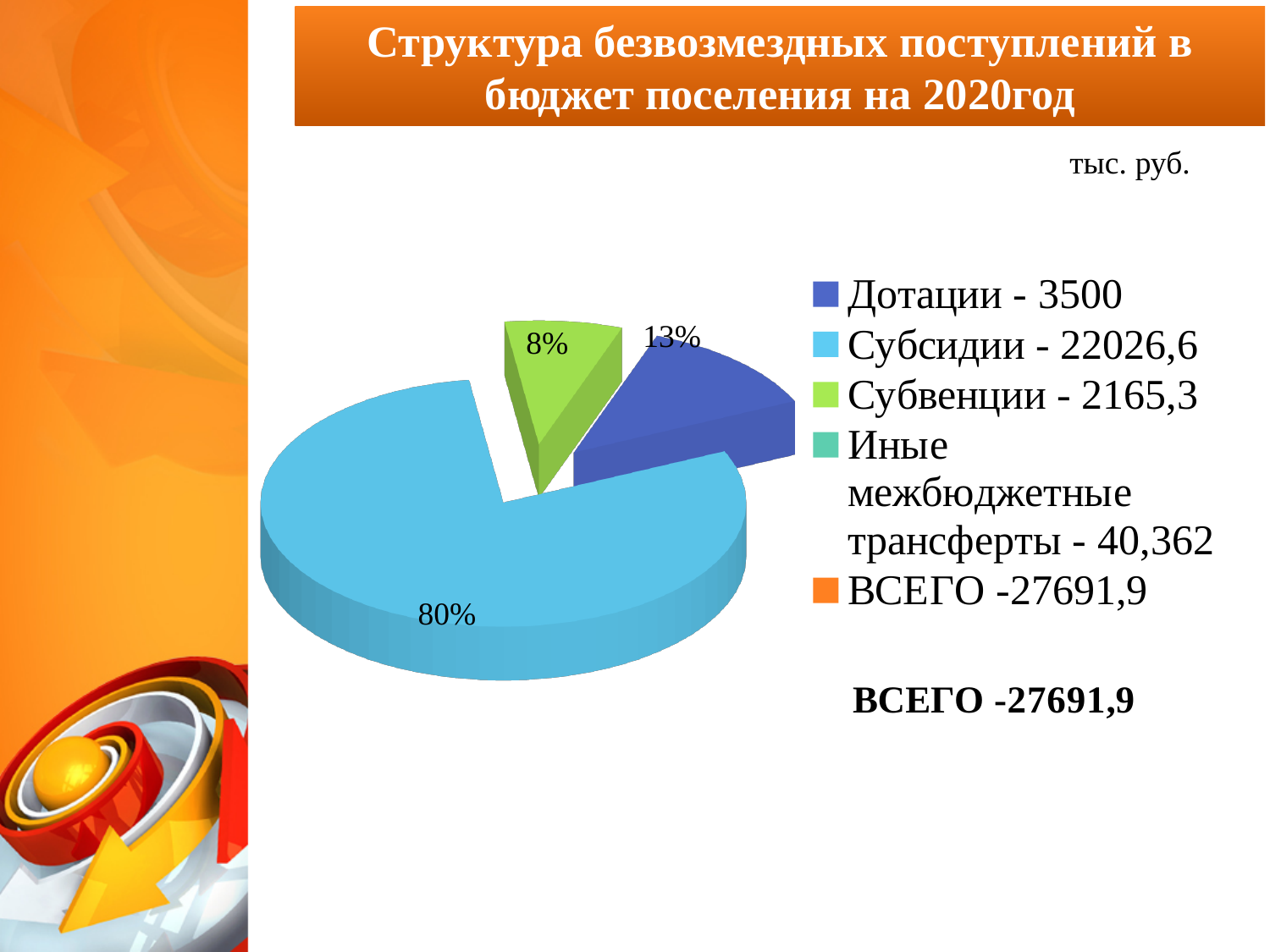
What share of the pie does Субвенции account for? 8% What share of the pie does Субсидии account for? 80% Which slice is larger, Дотации or Субвенции? Дотации How many entries does the legend list? 5 Which category has the largest slice of the pie? Субсидии What colour is the Субвенции slice? green Which of the labelled slices is the smallest: Дотации, Субсидии or Субвенции? Субвенции What share of the pie does Дотации account for? 13% What value does the legend give for Субсидии? 22026,6 What value does the legend give for Иные межбюджетные трансферты? 40,362 What kind of chart is shown on the slide? pie chart What is the difference in percentage points between the Дотации slice and the Субвенции slice? 5%